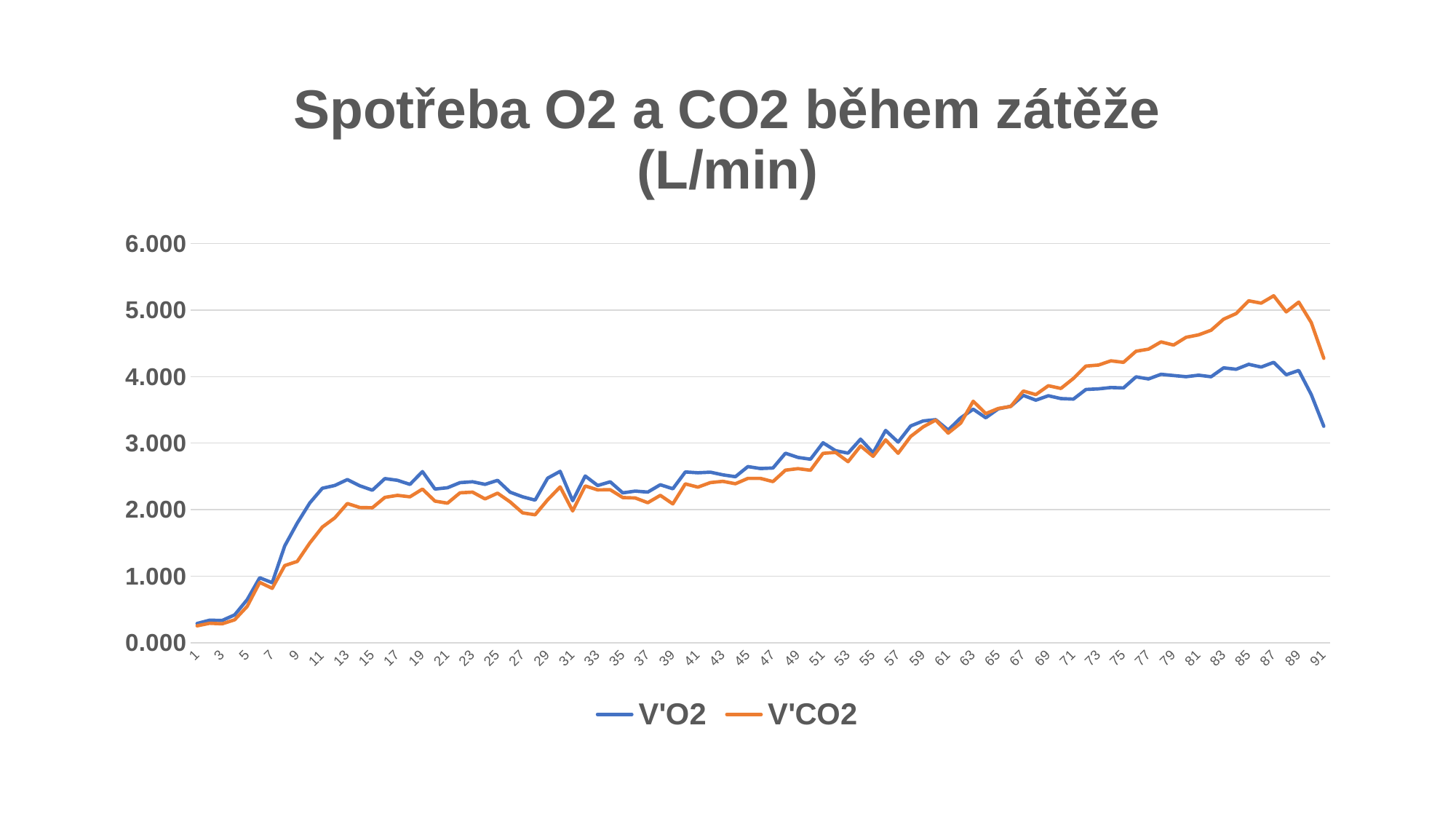
What kind of chart is shown on the slide? line chart Which series reaches the highest value anywhere on the chart? V'CO2 Is the value of V'CO2 at x = 11 greater or less than 2.000? less How many series does the legend list? 2 Is the value of V'CO2 at x = 87 greater or less than 5.000? greater Which series is drawn in orange? V'CO2 What is the title of the chart? Spotřeba O2 a CO2 během zátěže (L/min) Do the values of V'CO2 generally rise or fall from x = 1 to x = 87? rise Is the value of V'O2 at x = 11 greater or less than 2.000? greater At x = 13, which series has the larger value, V'O2 or V'CO2? V'O2 At x = 87, which series has the larger value, V'O2 or V'CO2? V'CO2